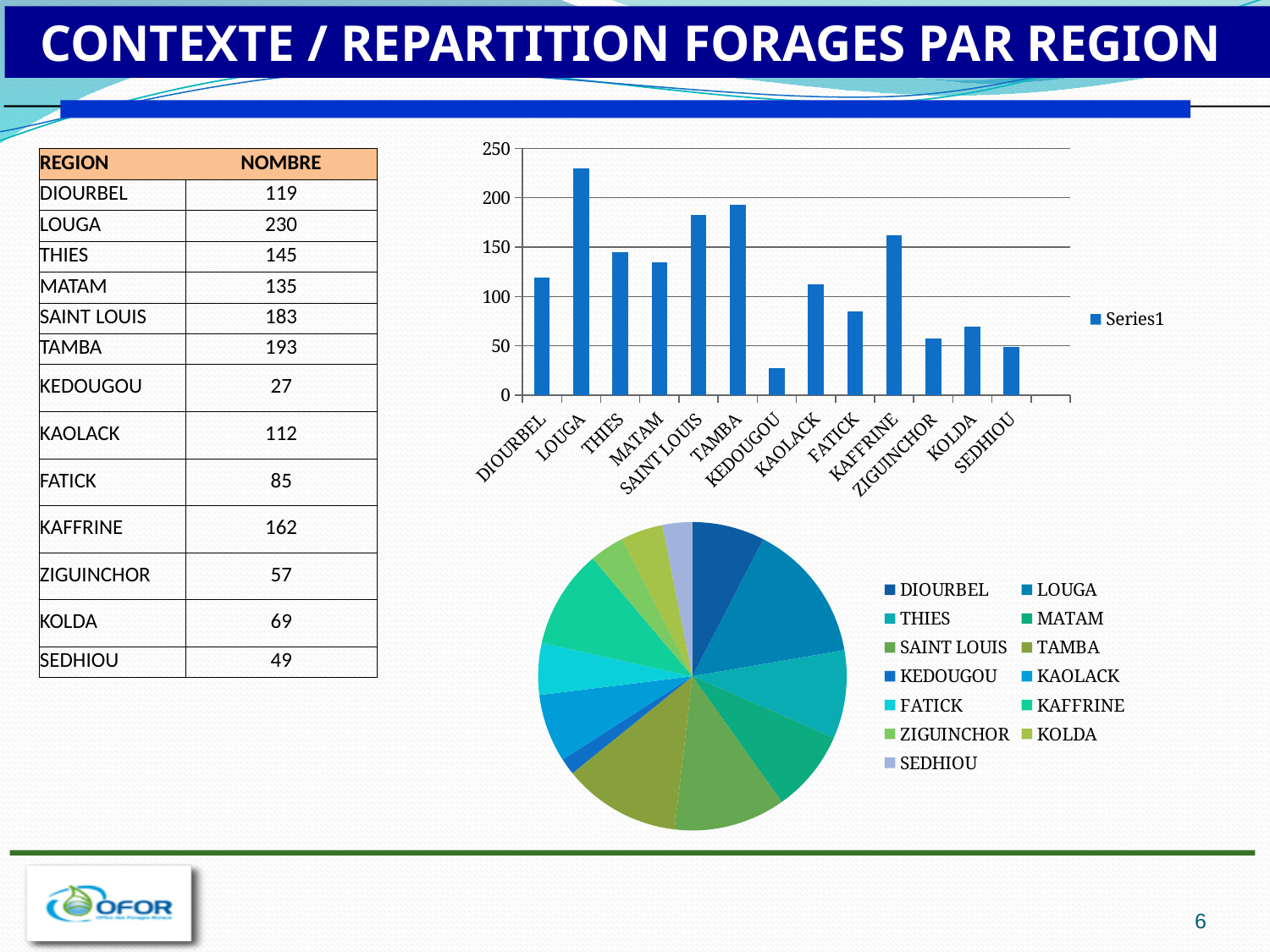
In the bar chart, is the value for KEDOUGOU greater or less than 50? less In the bar chart, is the value for LOUGA greater or less than 200? greater In the bar chart, which region has the highest value? LOUGA In the bar chart, which region has the lowest value? KEDOUGOU How many series does the legend of the bar chart list? 1 What type of chart is the lower chart on the slide? pie chart In the bar chart, which is larger, the value for KAFFRINE or the value for KAOLACK? KAFFRINE How many regions are shown on the x axis of the bar chart? 13 In the bar chart, which is larger, the value for TAMBA or the value for SAINT LOUIS? TAMBA What type of chart is the upper chart on the slide? bar chart What is the name of the series shown in the bar chart legend? Series1 How many entries does the legend of the pie chart list? 13